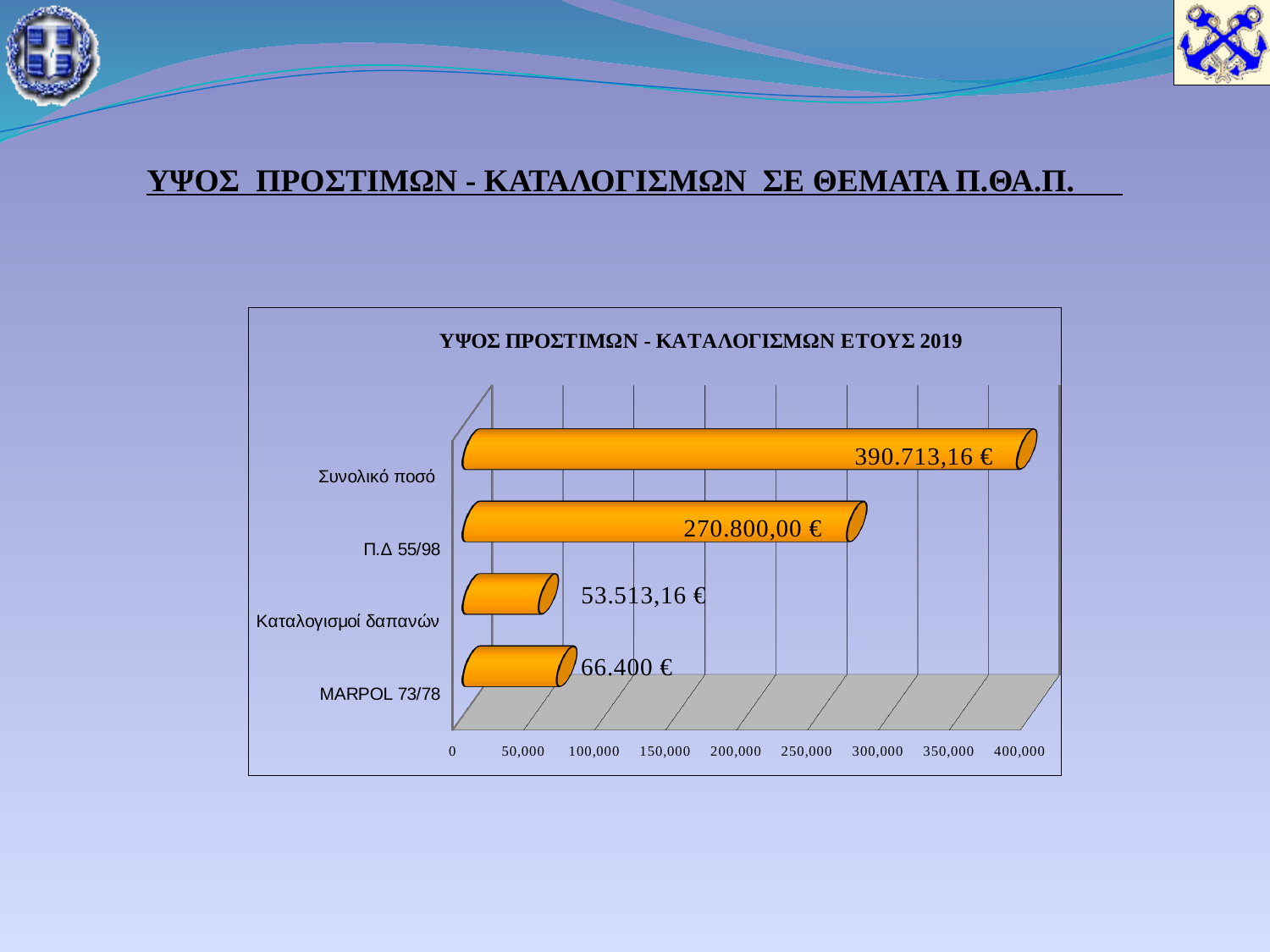
What is the difference between the values for Συνολικό ποσό and Π.Δ 55/98? 119.913,16 € Is the value for Π.Δ 55/98 greater or less than 250,000? greater Which category has the lowest value? Καταλογισμοί δαπανών What is the value shown for Π.Δ 55/98? 270.800,00 € How many categories are shown in the chart? 4 What is the value shown for Συνολικό ποσό? 390.713,16 € Which is larger, the value for MARPOL 73/78 or the value for Καταλογισμοί δαπανών? MARPOL 73/78 What is the difference between the values for MARPOL 73/78 and Καταλογισμοί δαπανών? 12.886,84 € What type of chart is shown on the slide? Bar chart Which category has the highest value? Συνολικό ποσό What is the value shown for Καταλογισμοί δαπανών? 53.513,16 € What is the value shown for MARPOL 73/78? 66.400 €